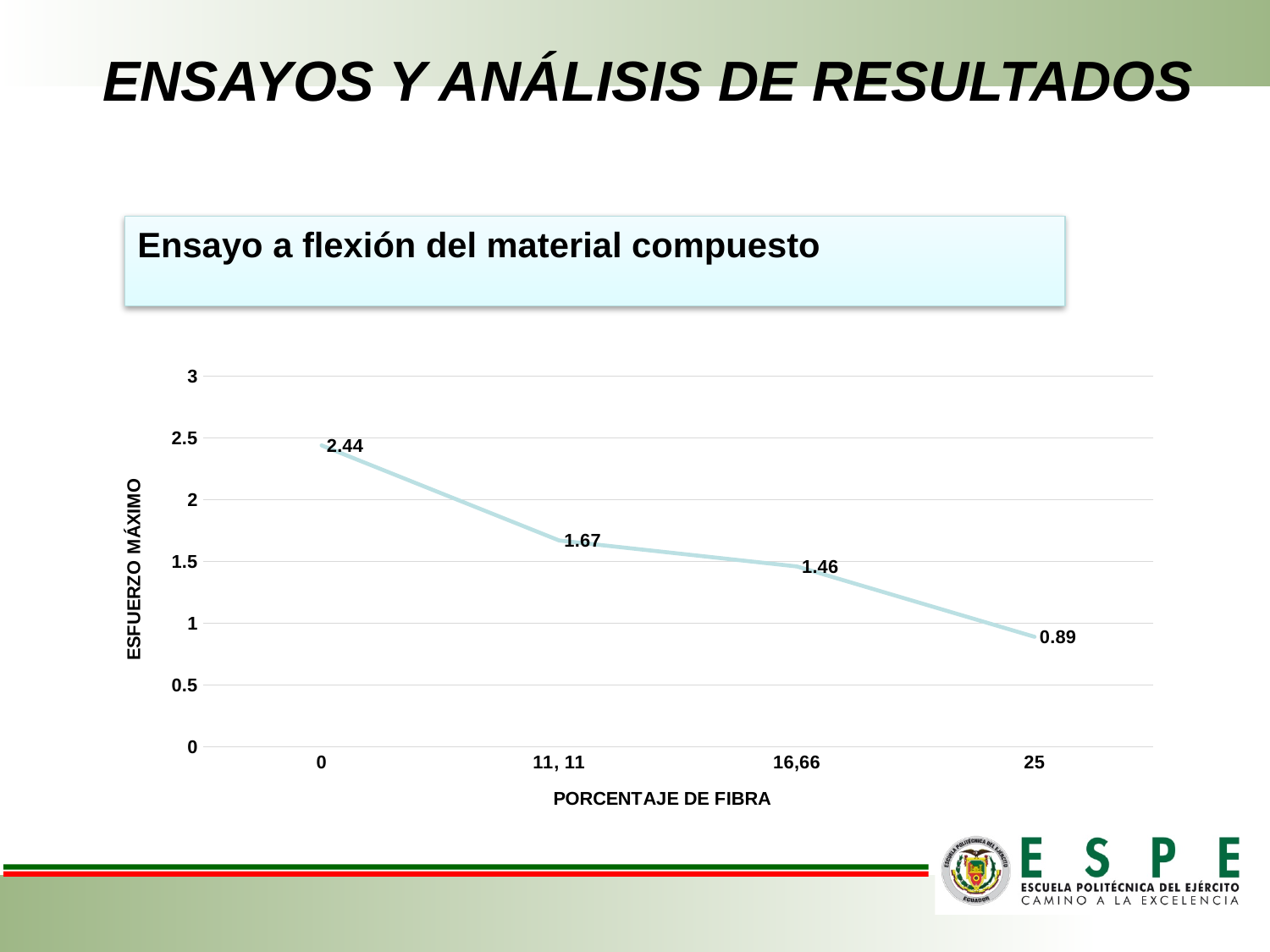
At which PORCENTAJE DE FIBRA is the ESFUERZO MÁXIMO highest? 0 What is the ESFUERZO MÁXIMO value at a PORCENTAJE DE FIBRA of 0? 2.44 What is the ESFUERZO MÁXIMO value at a PORCENTAJE DE FIBRA of 11, 11? 1.67 What is the difference in ESFUERZO MÁXIMO between a PORCENTAJE DE FIBRA of 0 and of 25? 1.55 What kind of chart is shown on the slide? Line chart At which PORCENTAJE DE FIBRA is the ESFUERZO MÁXIMO lowest? 25 Does the ESFUERZO MÁXIMO rise or fall as the PORCENTAJE DE FIBRA increases? Fall Which has a larger ESFUERZO MÁXIMO: a PORCENTAJE DE FIBRA of 11, 11 or of 25? 11, 11 What is the ESFUERZO MÁXIMO value at a PORCENTAJE DE FIBRA of 16,66? 1.46 What is the ESFUERZO MÁXIMO value at a PORCENTAJE DE FIBRA of 25? 0.89 How many data points are plotted on the chart? 4 What is the difference in ESFUERZO MÁXIMO between a PORCENTAJE DE FIBRA of 11, 11 and of 16,66? 0.21